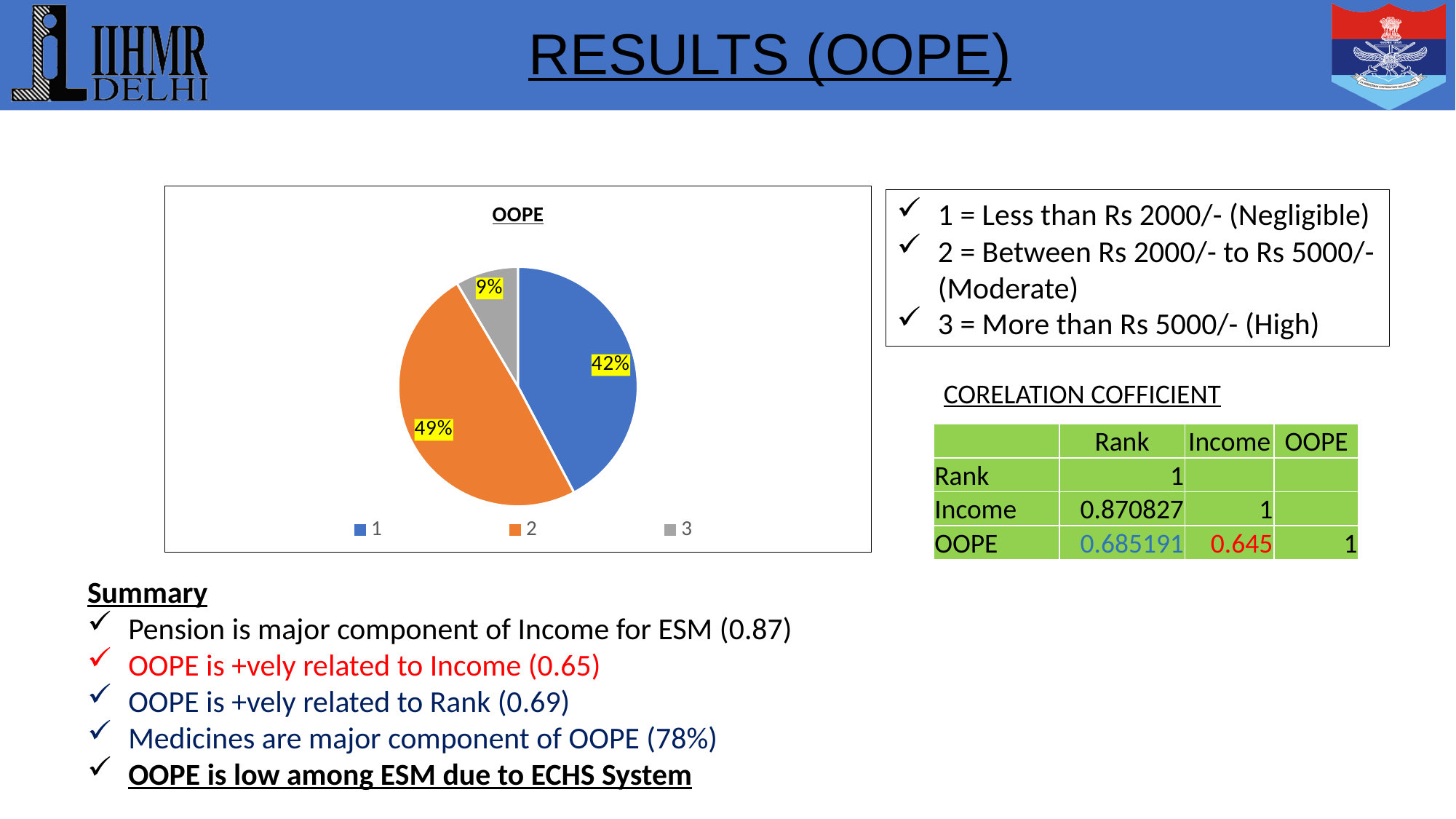
How many slices does the pie chart have? 3 What colour is the slice for category 2? orange What share of the pie does category 3 have? 9% Which is larger, the slice for category 1 or the slice for category 3? 1 What share of the pie does category 2 have? 49% Which category has the largest slice of the pie? 2 What kind of chart is shown on the slide? pie chart Which category has the smallest slice of the pie? 3 What is the title of the chart? OOPE What share of the pie does category 1 have? 42% What is the difference in percentage points between category 2 and category 1? 7% How many entries does the legend list? 3